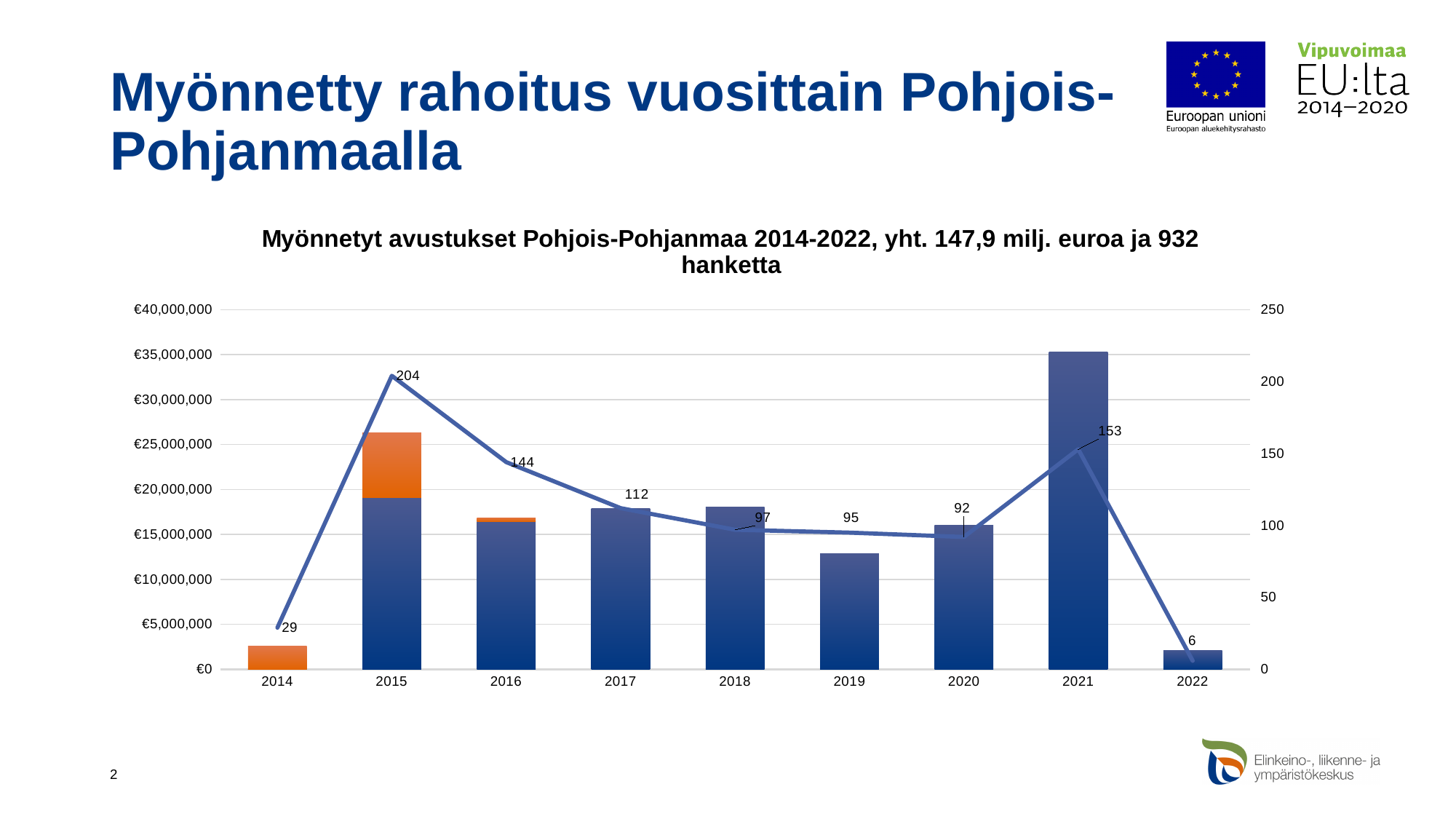
What is the line value shown for 2018? 97 Which year has a larger line value, 2017 or 2021? 2021 Is the bar value for 2021 greater or less than €30,000,000? greater How many years are shown on the x axis? 9 What is the line value shown for 2022? 6 What is the difference between the line values for 2015 and 2016? 60 Which year has the highest line value? 2015 What is the title of the chart? Myönnetyt avustukset Pohjois-Pohjanmaa 2014-2022, yht. 147,9 milj. euroa ja 932 hanketta Does the line value rise or fall from 2015 to 2020? fall Which year has the lowest line value? 2022 What is the line value (number of projects) shown for 2015? 204 Is the bar value for 2019 greater or less than €15,000,000? less